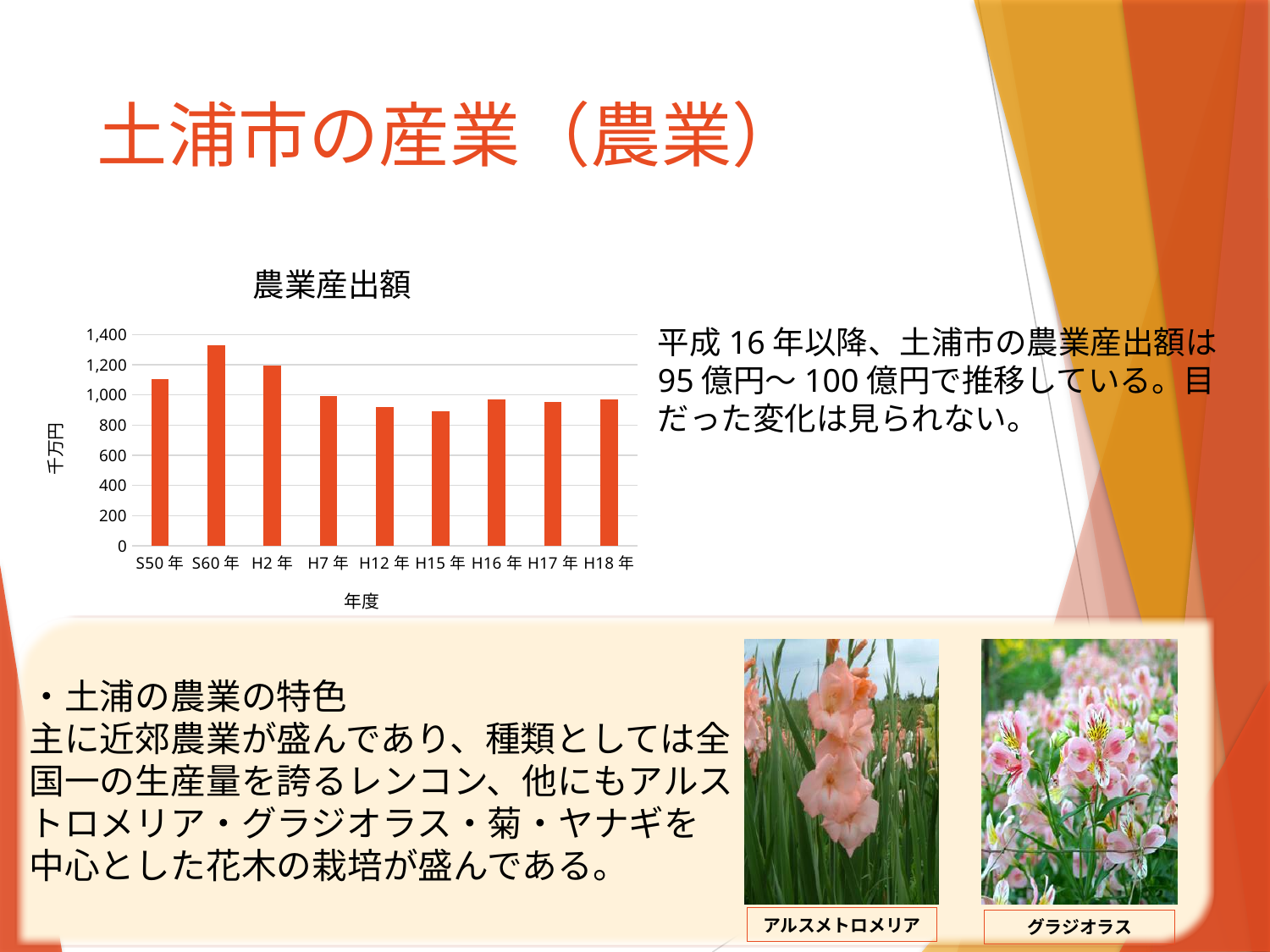
What is the title of the chart? 農業産出額 Is the value for S60年 greater or less than 1,200? greater Is the value for H12年 greater or less than 1,000? less How many years (categories) are plotted in the chart? 9 Do the values rise or fall from S60年 to H15年? fall Is the value for H15年 greater or less than 1,000? less Which is larger, the value for S50年 or the value for H12年? S50年 Which year has the highest 農業産出額 in the chart? S60年 What is the label on the vertical axis of the chart? 千万円 What kind of chart is shown on the slide? bar chart Which is larger, the value for S60年 or the value for H2年? S60年